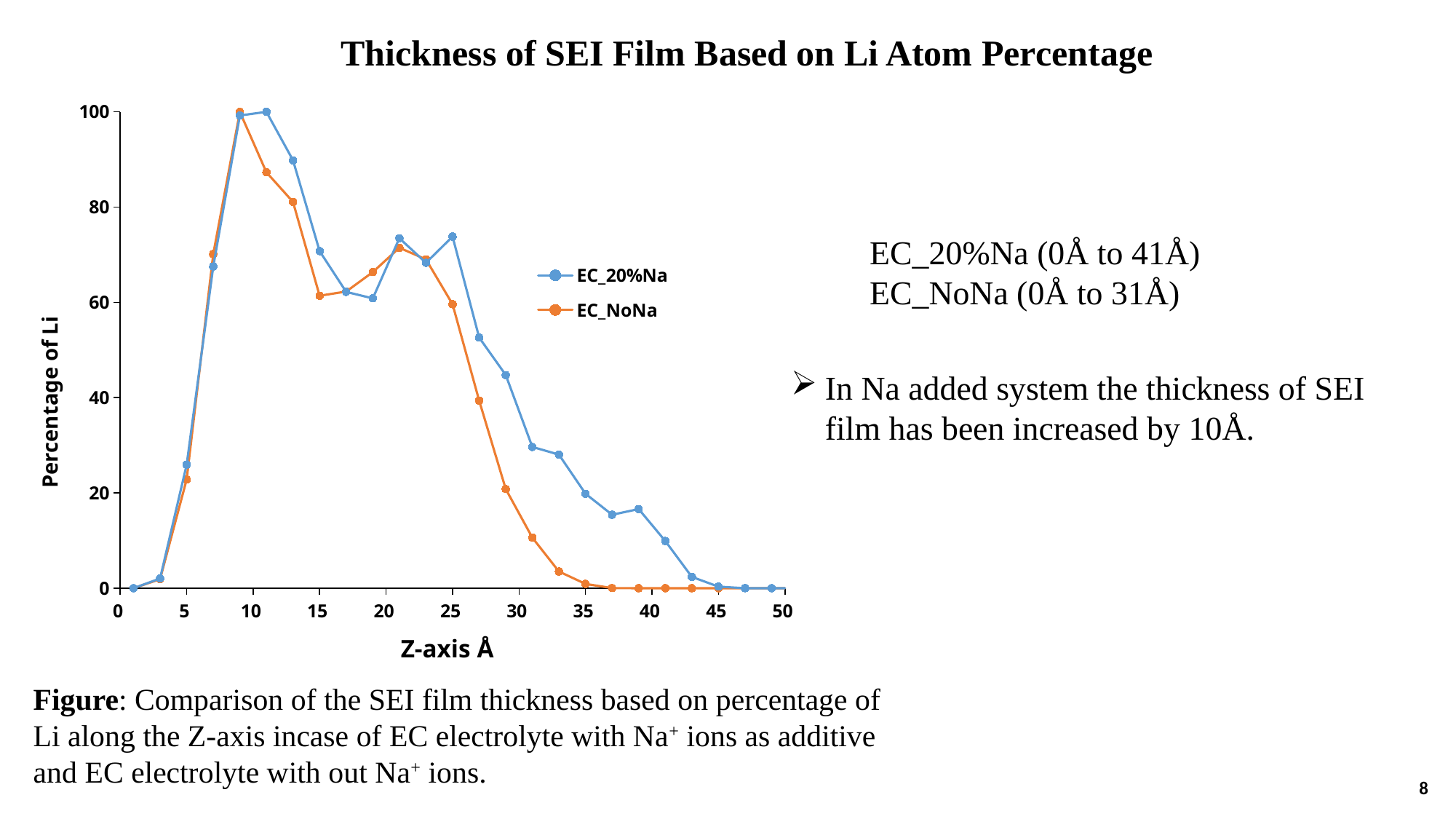
At 15 Å, which series has the higher percentage of Li, EC_20%Na or EC_NoNa? EC_20%Na Between 25 Å and 35 Å, does the EC_NoNa series rise or fall? fall How many series does the legend list? 2 Is the value for EC_20%Na at 13 Å greater or less than 80? greater Is the value for EC_20%Na at 29 Å greater or less than 40? greater Is the value for EC_NoNa at 11 Å greater or less than 80? greater At 29 Å, which series has the higher percentage of Li, EC_20%Na or EC_NoNa? EC_20%Na What are the two series named in the legend? EC_20%Na and EC_NoNa What is the label of the y axis? Percentage of Li What kind of chart is shown on the slide? line chart